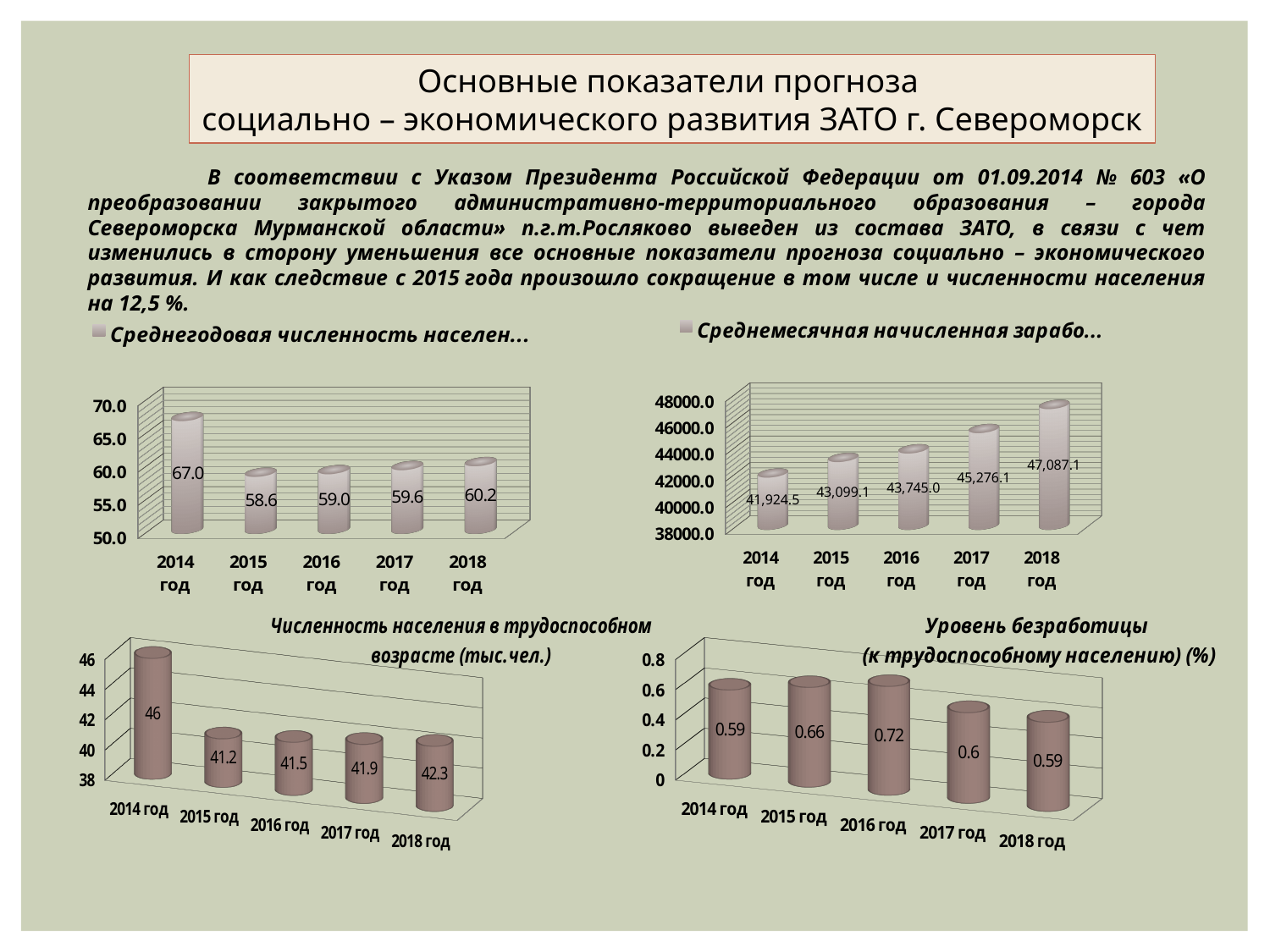
In the chart titled 'Уровень безработицы (к трудоспособному населению) (%)', what is the value for 2016 год? 0.72 In the top-left chart (Среднегодовая численность населения), what is the value for 2014 год? 67.0 In the top-right chart (Среднемесячная начисленная заработная плата), what is the value for 2017 год? 45,276.1 In the top-left chart (Среднегодовая численность населения), what is the difference between the 2014 год and 2018 год values? 6.8 In the chart titled 'Численность населения в трудоспособном возрасте (тыс.чел.)', what is the value for 2016 год? 41.5 In the top-right chart (Среднемесячная начисленная заработная плата), do the values rise or fall from 2014 год to 2018 год? rise What kind of chart is the chart titled 'Численность населения в трудоспособном возрасте (тыс.чел.)'? bar chart How many years are plotted in the chart titled 'Уровень безработицы (к трудоспособному населению) (%)'? 5 In the top-left chart (Среднегодовая численность населения), which year has the lowest value? 2015 год In the top-right chart (Среднемесячная начисленная заработная плата), which year has the highest value? 2018 год In the chart titled 'Уровень безработицы (к трудоспособному населению) (%)', which is larger, the value for 2015 год or 2017 год? 2015 год In the chart titled 'Численность населения в трудоспособном возрасте (тыс.чел.)', which year has the highest value? 2014 год